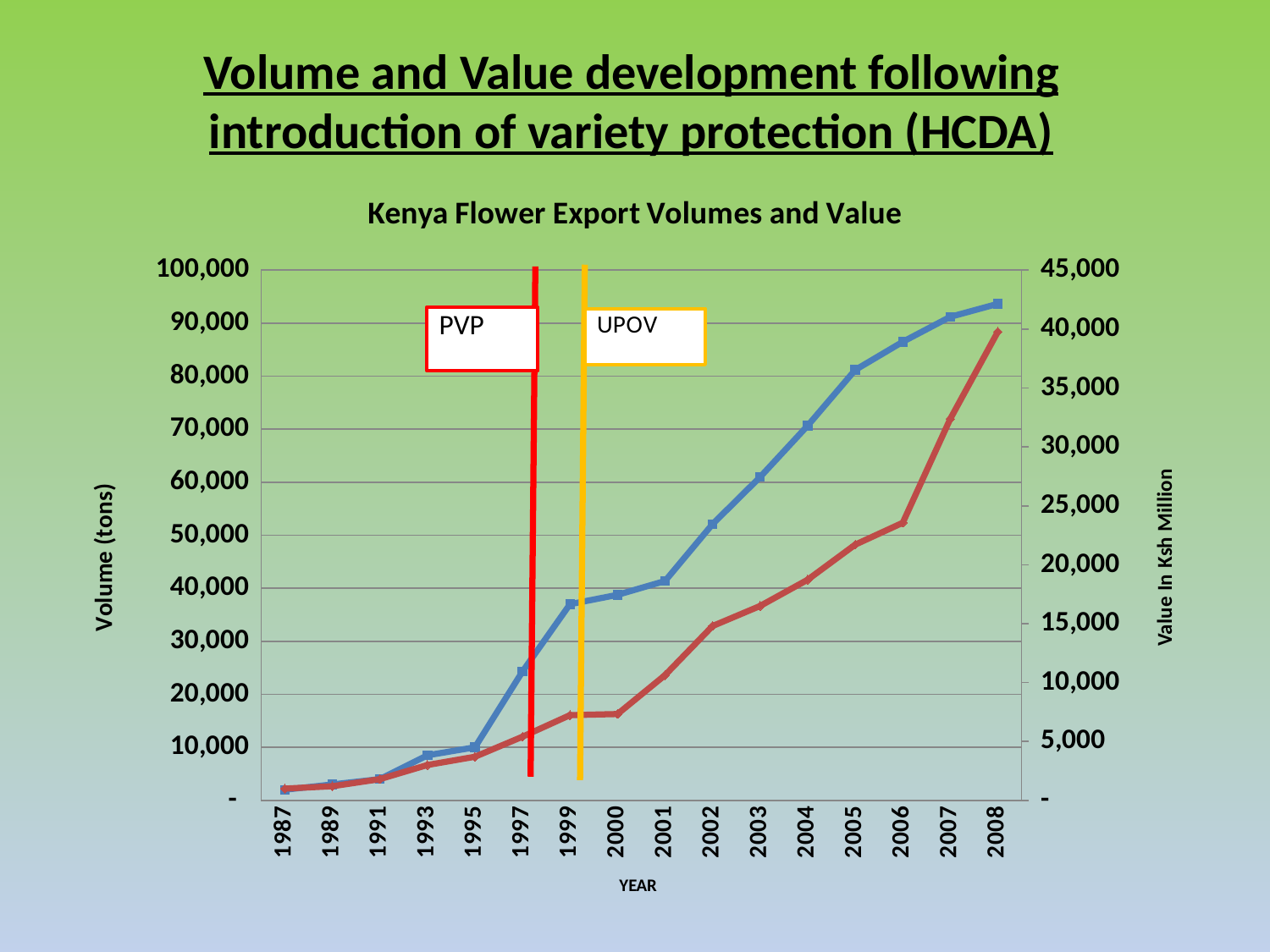
Which year has the lowest value (red line) in the chart? 1987 Is the volume (blue line, left axis) for 1999 greater or less than 40,000? less Which year has the highest volume (blue line) in the chart? 2008 Is the volume (blue line, left axis) for 2008 greater or less than 90,000? greater Is the value (red line, right axis) for 2004 greater or less than 20,000? less Does the volume (blue line) rise or fall from 1987 to 2008? Rise What is the title of the chart? Kenya Flower Export Volumes and Value How many years are plotted along the x axis of the chart? 16 What kind of chart is shown on the slide? Line chart Is the volume (blue line) for 2005 larger or smaller than the volume for 2002? larger What is the label of the left vertical axis? Volume (tons)